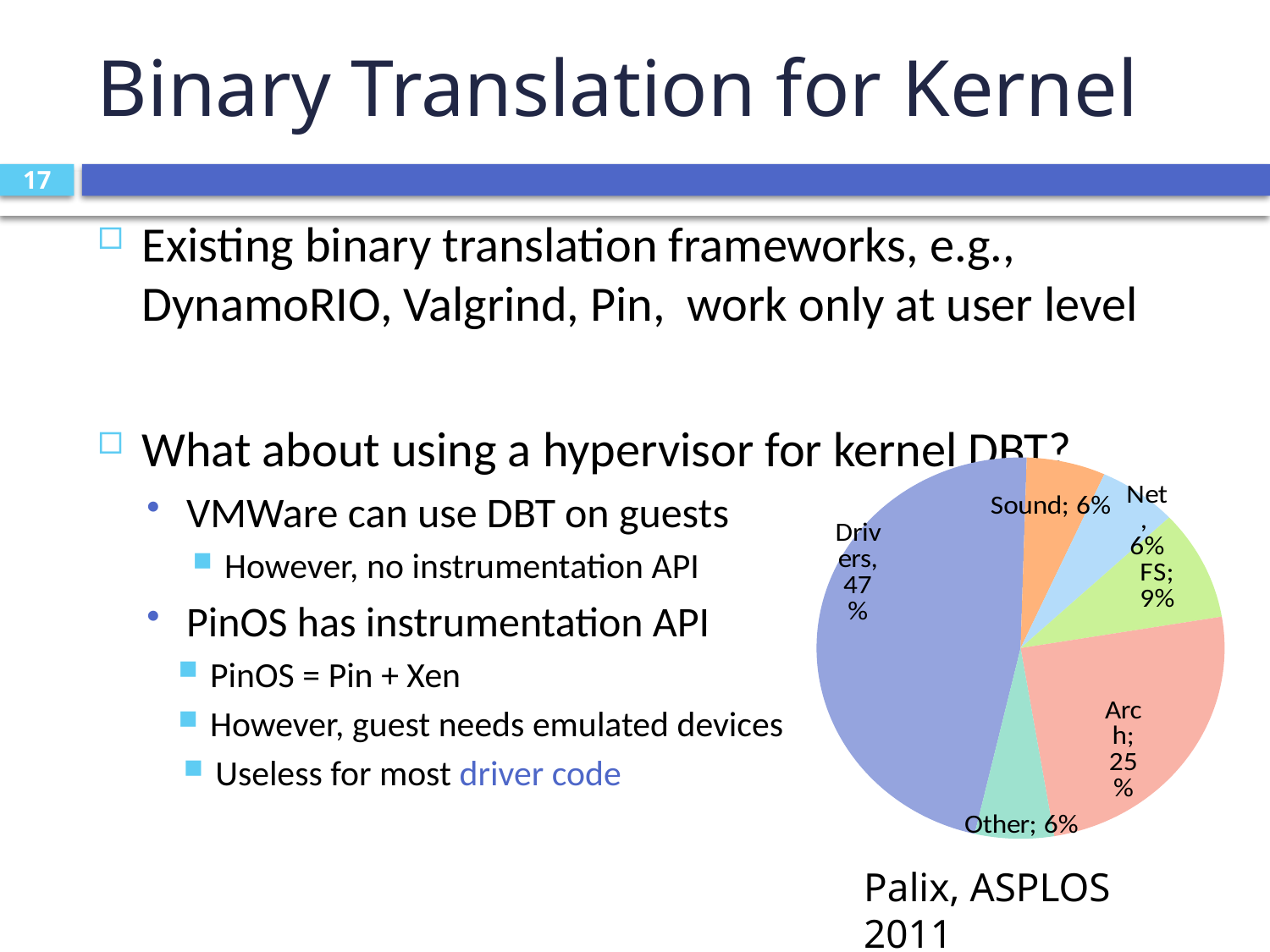
What is the value shown for Sound in the pie chart? 6% What kind of chart is shown on the slide? pie chart What is the difference between the Drivers share and the Arch share in the pie chart? 22% What is the difference between the Arch share and the FS share in the pie chart? 16% What is the value shown for Other in the pie chart? 6% Which is larger in the pie chart, FS or Net? FS How many slices does the pie chart have? 6 What share of the pie does the Drivers slice represent? 47% What share of the pie does the Arch slice represent? 25% Which slice of the pie chart is the largest? Drivers What source is cited below the pie chart? Palix, ASPLOS 2011 What is the value shown for FS in the pie chart? 9%